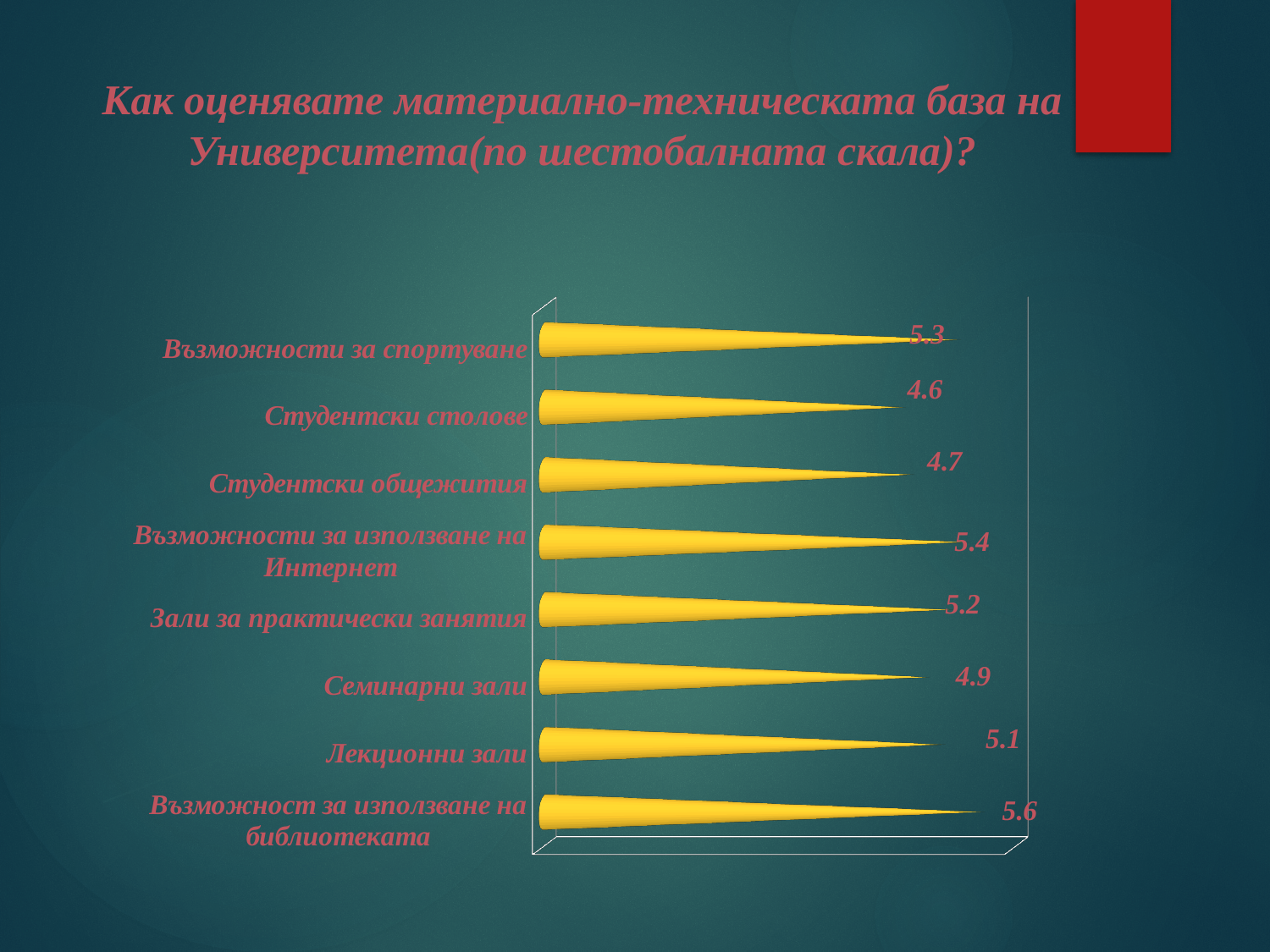
What kind of chart is shown on the slide? Bar chart What is the value for Лекционни зали? 5.1 Which category has the highest value? Възможност за използване на библиотеката What is the value for Студентски столове? 4.6 What is the value for Възможности за използване на Интернет? 5.4 What colour are the bars in the chart? Yellow Which is larger, the value for Студентски общежития or the value for Зали за практически занятия? Зали за практически занятия What is the difference between the values for Възможност за използване на библиотеката and Студентски столове? 1.0 Which category has the lowest value? Студентски столове What is the difference between the values for Възможности за използване на Интернет and Семинарни зали? 0.5 What is the value for Възможности за спортуване? 5.3 How many categories are shown in the chart? 8